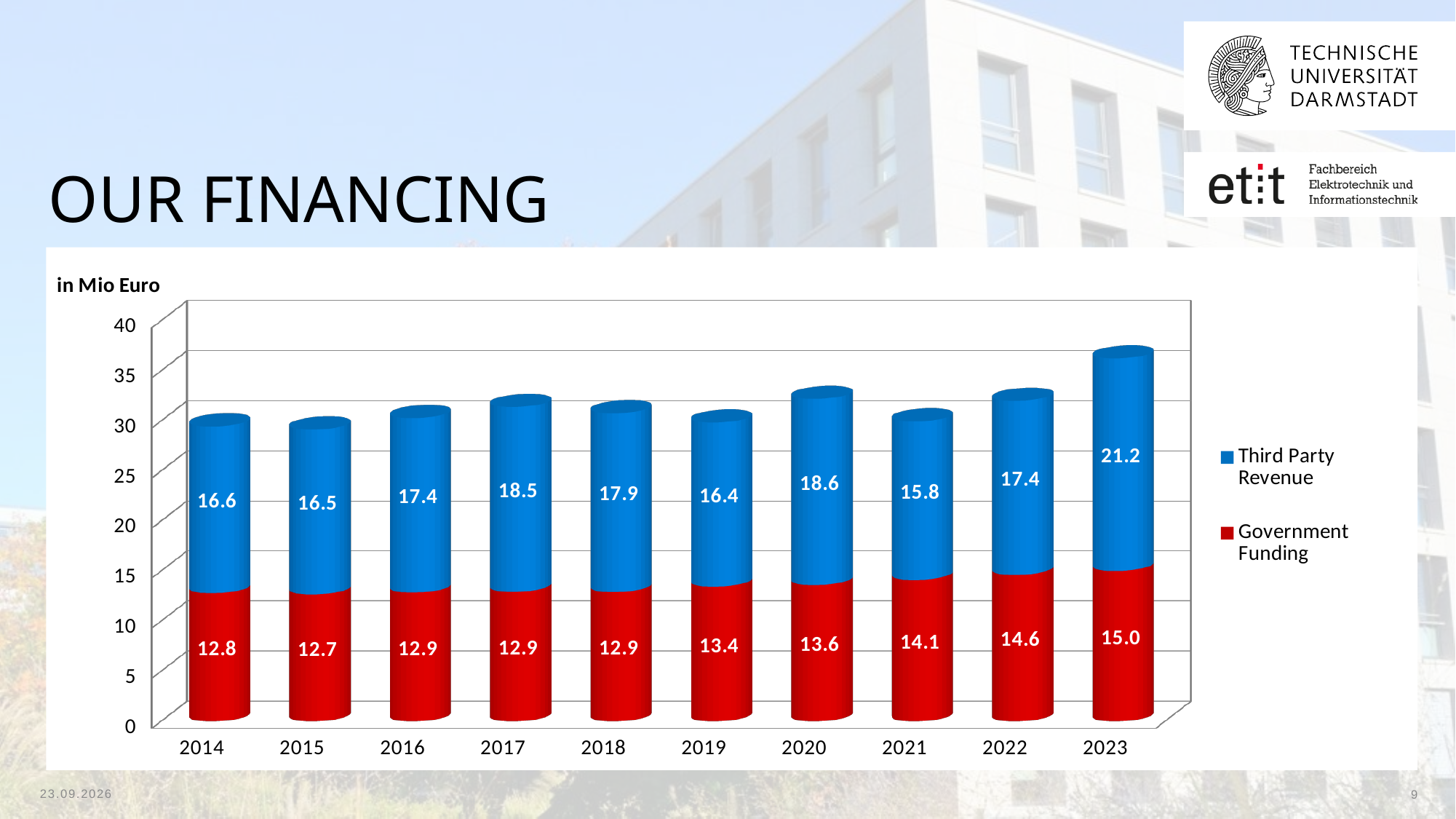
Which year has the lowest Government Funding? 2015 How many years are shown on the x axis? 10 What is the total of the stacked bar for 2015? 29.2 What kind of chart is shown on the slide? Stacked bar chart What is the Third Party Revenue value for 2023? 21.2 What is the difference between Third Party Revenue and Government Funding in 2020? 5.0 What is the Third Party Revenue value for 2019? 16.4 How many series does the legend list? 2 What is the total of the stacked bar for 2023? 36.2 What is the Government Funding value for 2014? 12.8 Which is larger in 2021: Third Party Revenue or Government Funding? Third Party Revenue Which year has the highest Third Party Revenue? 2023